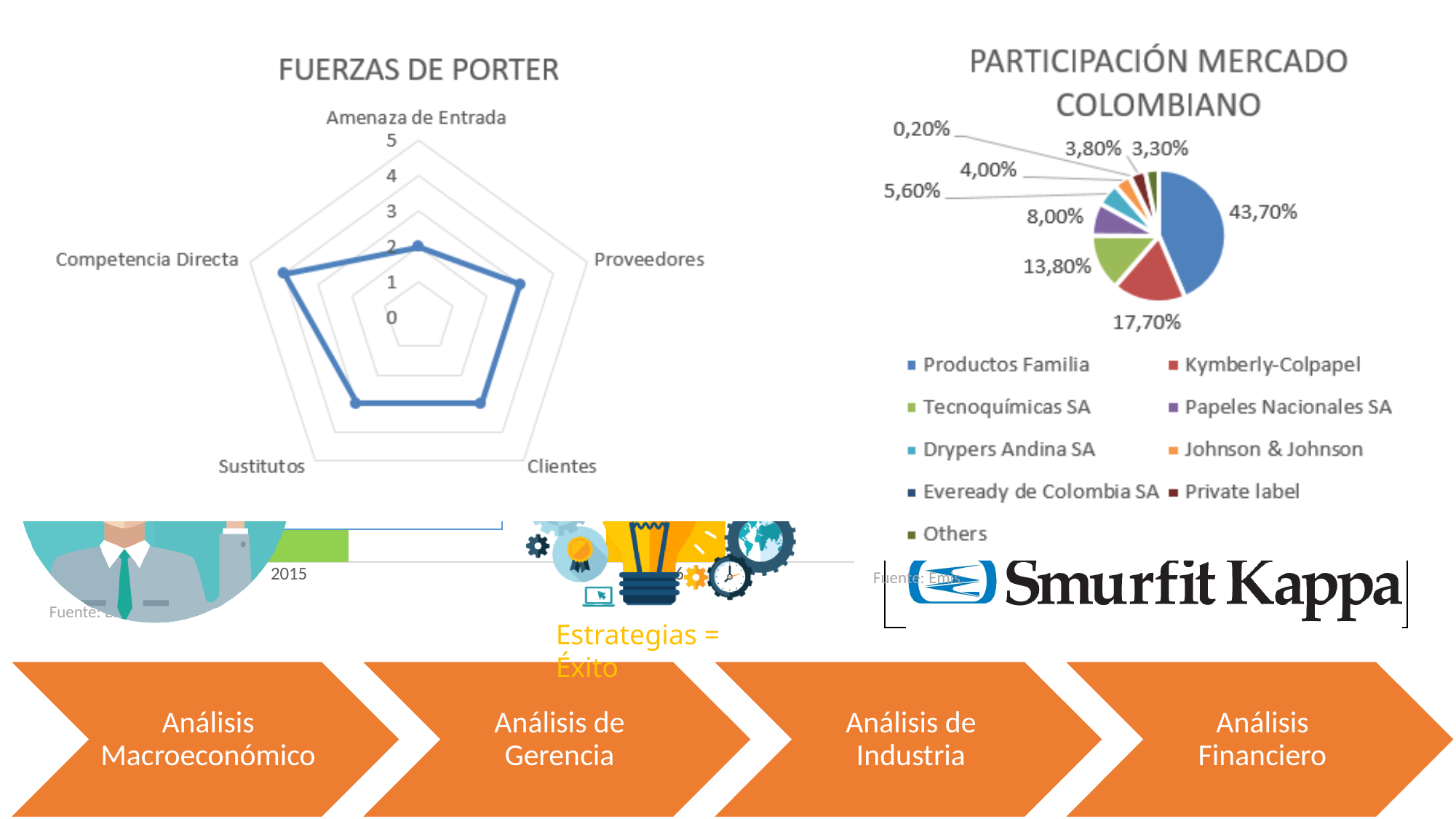
In the 'FUERZAS DE PORTER' chart, what is the value for Amenaza de Entrada? 2 In the 'PARTICIPACIÓN MERCADO COLOMBIANO' chart, which has a larger share, Tecnoquímicas SA or Papeles Nacionales SA? Tecnoquímicas SA In the 'PARTICIPACIÓN MERCADO COLOMBIANO' chart, what is the market share of Kymberly-Colpapel? 17,70% In the 'FUERZAS DE PORTER' chart, is the value for Competencia Directa greater or less than 3? greater How many companies/categories are listed in the legend of the 'PARTICIPACIÓN MERCADO COLOMBIANO' chart? 9 In the 'PARTICIPACIÓN MERCADO COLOMBIANO' chart, what is the market share of Papeles Nacionales SA? 8,00% What type of chart is the 'FUERZAS DE PORTER' chart? radar chart In the 'PARTICIPACIÓN MERCADO COLOMBIANO' chart, what is the market share of Productos Familia? 43,70% How many forces (axes) are shown in the 'FUERZAS DE PORTER' chart? 5 In the 'PARTICIPACIÓN MERCADO COLOMBIANO' chart, which company has the largest market share? Productos Familia What type of chart is the 'PARTICIPACIÓN MERCADO COLOMBIANO' chart? pie chart In the 'PARTICIPACIÓN MERCADO COLOMBIANO' chart, what is the difference between the shares of Productos Familia and Kymberly-Colpapel? 26,00%